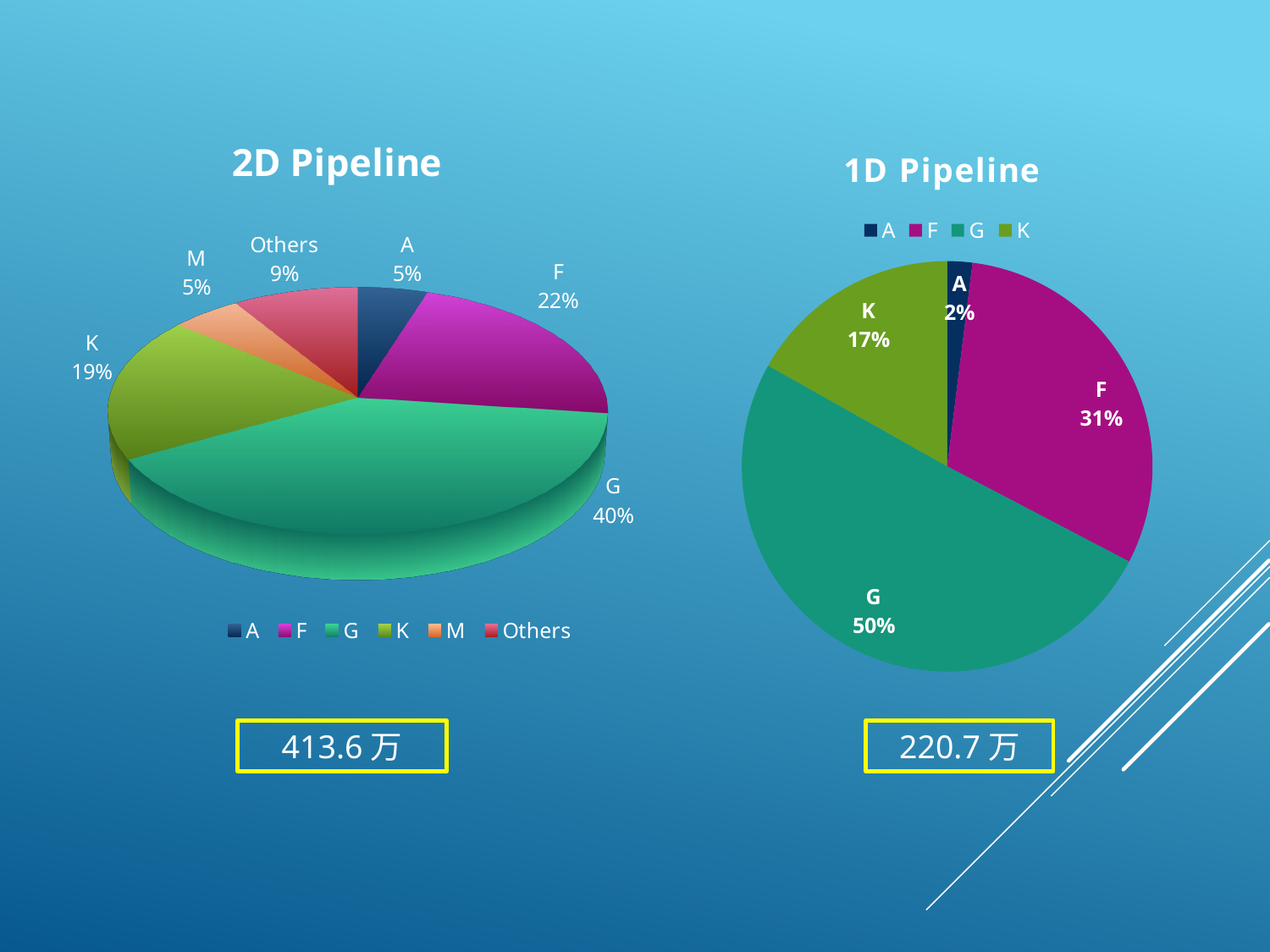
In the 1D Pipeline chart, what is the difference between the shares of G and K? 33% In the 2D Pipeline chart, what share does G have? 40% In the 2D Pipeline chart, what share does K have? 19% In the 2D Pipeline chart, which category has the largest slice? G In the 2D Pipeline chart, which is larger, the share of Others or the share of M? Others In the 1D Pipeline chart, what share does A have? 2% How many categories does the 2D Pipeline chart show? 6 In the 1D Pipeline chart, what share does F have? 31% In the 1D Pipeline chart, which category has the smallest slice? A What kind of chart is the 1D Pipeline chart? Pie chart In the 2D Pipeline chart, what is the difference between the shares of F and A? 17% How many entries does the legend of the 1D Pipeline chart list? 4